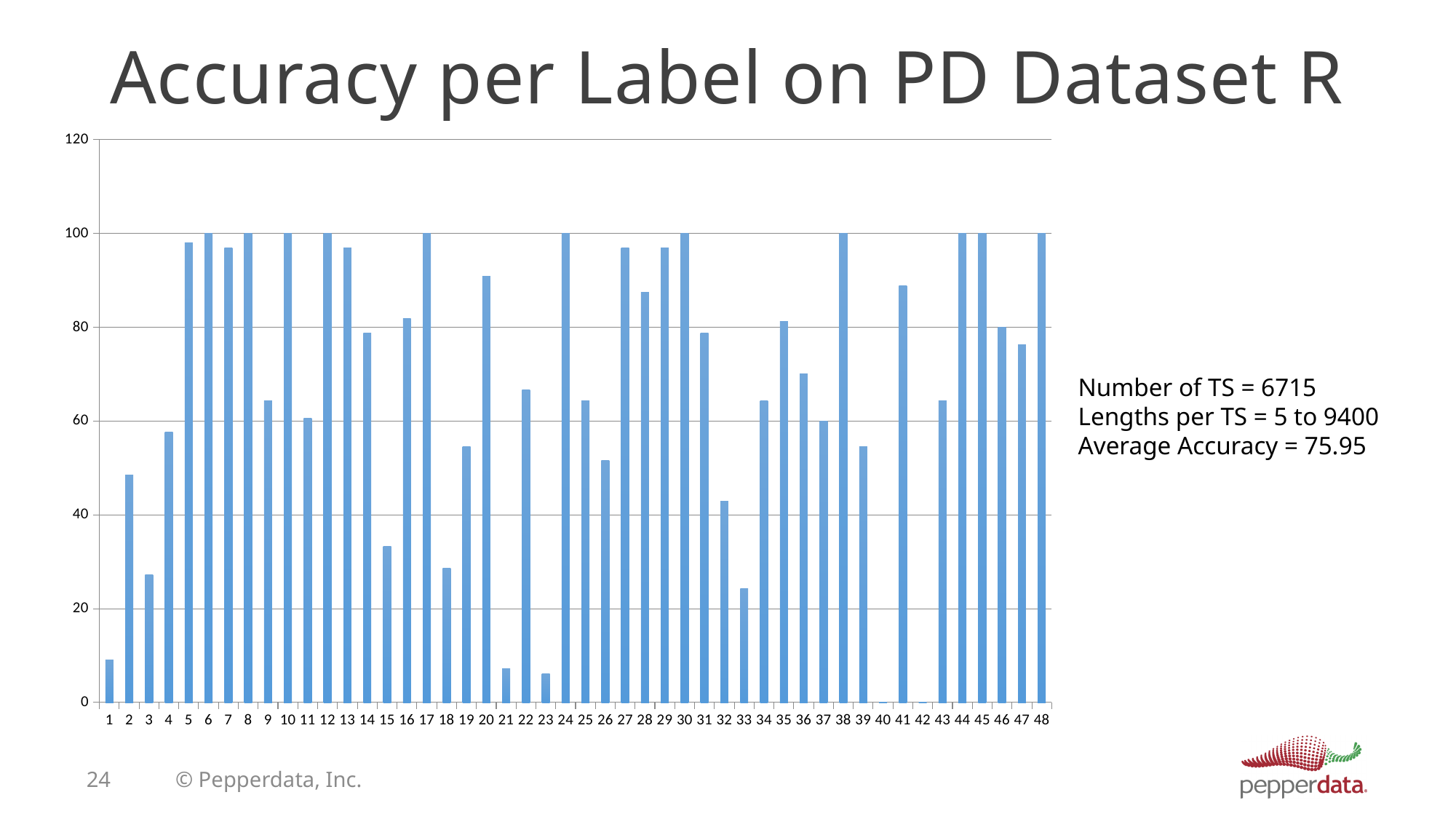
What kind of chart is shown on the slide? bar chart What is the accuracy value for label 6? 100 Which has the larger value, label 1 or label 2? label 2 What is the accuracy value for label 24? 100 What is the accuracy value for label 48? 100 Is the value for label 1 greater or less than 20? less What is the title of the chart? Accuracy per Label on PD Dataset R How many labels (categories) are plotted along the x axis? 48 Is the value for label 2 greater or less than 40? greater Which has the larger value, label 21 or label 22? label 22 Is the value for label 20 greater or less than 80? greater